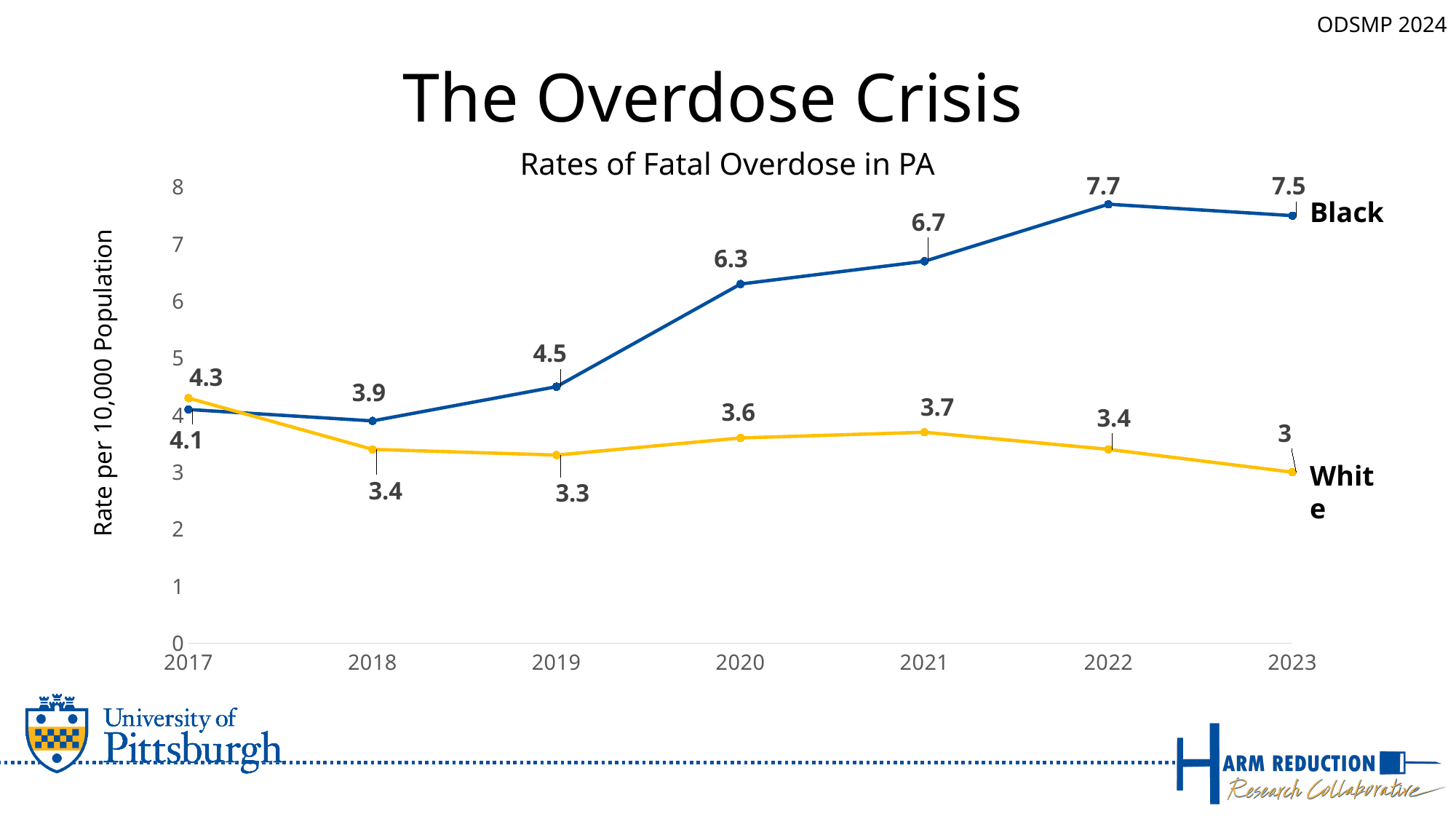
What kind of chart is shown on the slide? Line chart What is the rate for the Black series in 2017? 4.1 In which year is the White series at its lowest? 2023 How many years are plotted on the x axis? 7 What is the rate of fatal overdose for the Black series in 2022? 7.7 Which series has the higher rate in 2017, Black or White? White What is the rate of fatal overdose for the White series in 2019? 3.3 How many series are plotted on the chart? 2 What is the difference between the Black and White rates in 2023? 4.5 What is the rate for the White series in 2023? 3 In which year is the Black series at its highest? 2022 What is the title of the chart? Rates of Fatal Overdose in PA